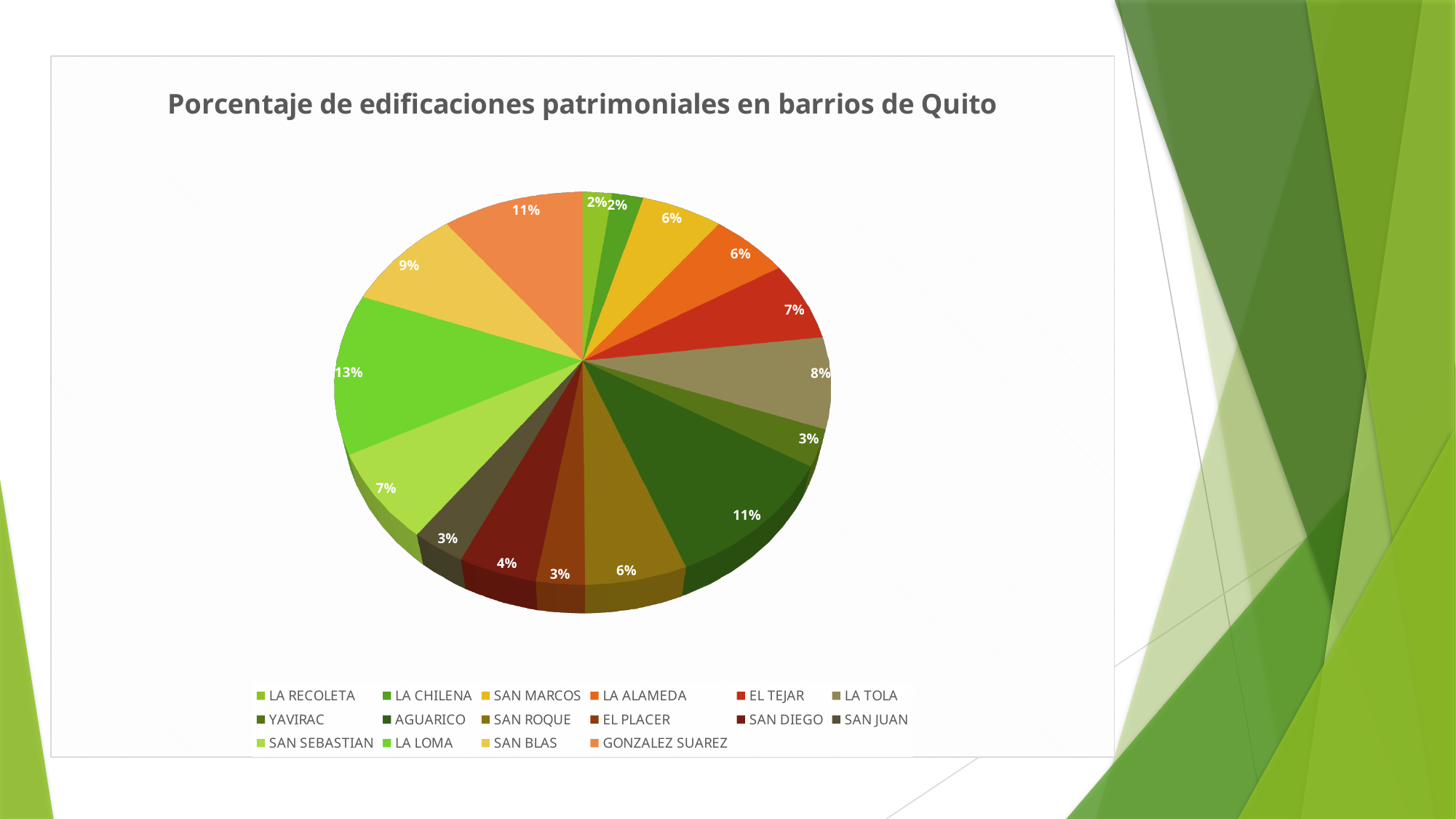
What is the title of the chart? Porcentaje de edificaciones patrimoniales en barrios de Quito What percentage is shown for LA TOLA? 8% Which barrio has the largest share of the pie? LA LOMA What is the difference between the shares of LA LOMA and EL TEJAR? 6% Which has a larger share, GONZALEZ SUAREZ or SAN BLAS? GONZALEZ SUAREZ What is the combined share of LA RECOLETA and LA CHILENA? 4% What type of chart is shown on the slide? pie chart How many barrios (categories) are shown in the pie chart? 16 What percentage is shown for LA LOMA? 13% What percentage is shown for AGUARICO? 11% What percentage is shown for SAN DIEGO? 4% What percentage is shown for SAN BLAS? 9%